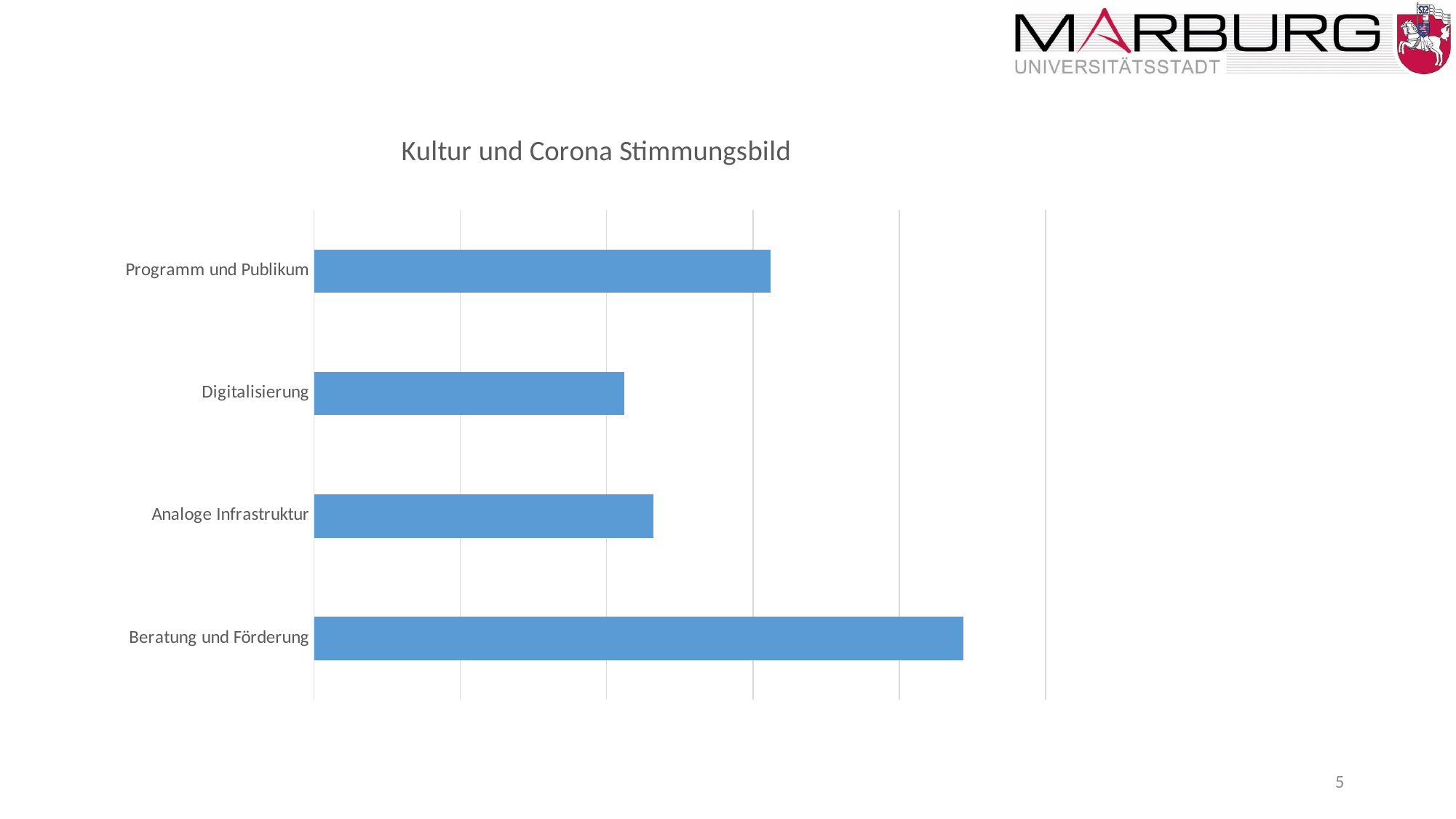
Which has the larger value, Analoge Infrastruktur or Digitalisierung? Analoge Infrastruktur Which has the larger value, Programm und Publikum or Analoge Infrastruktur? Programm und Publikum Which category is listed at the top of the chart? Programm und Publikum What kind of chart is shown on the slide? bar chart Which category has the longest bar? Beratung und Förderung What is the title of the chart? Kultur und Corona Stimmungsbild How many categories are shown in the chart? 4 Which has the larger value, Digitalisierung or Beratung und Förderung? Beratung und Förderung Which category has the shortest bar? Digitalisierung